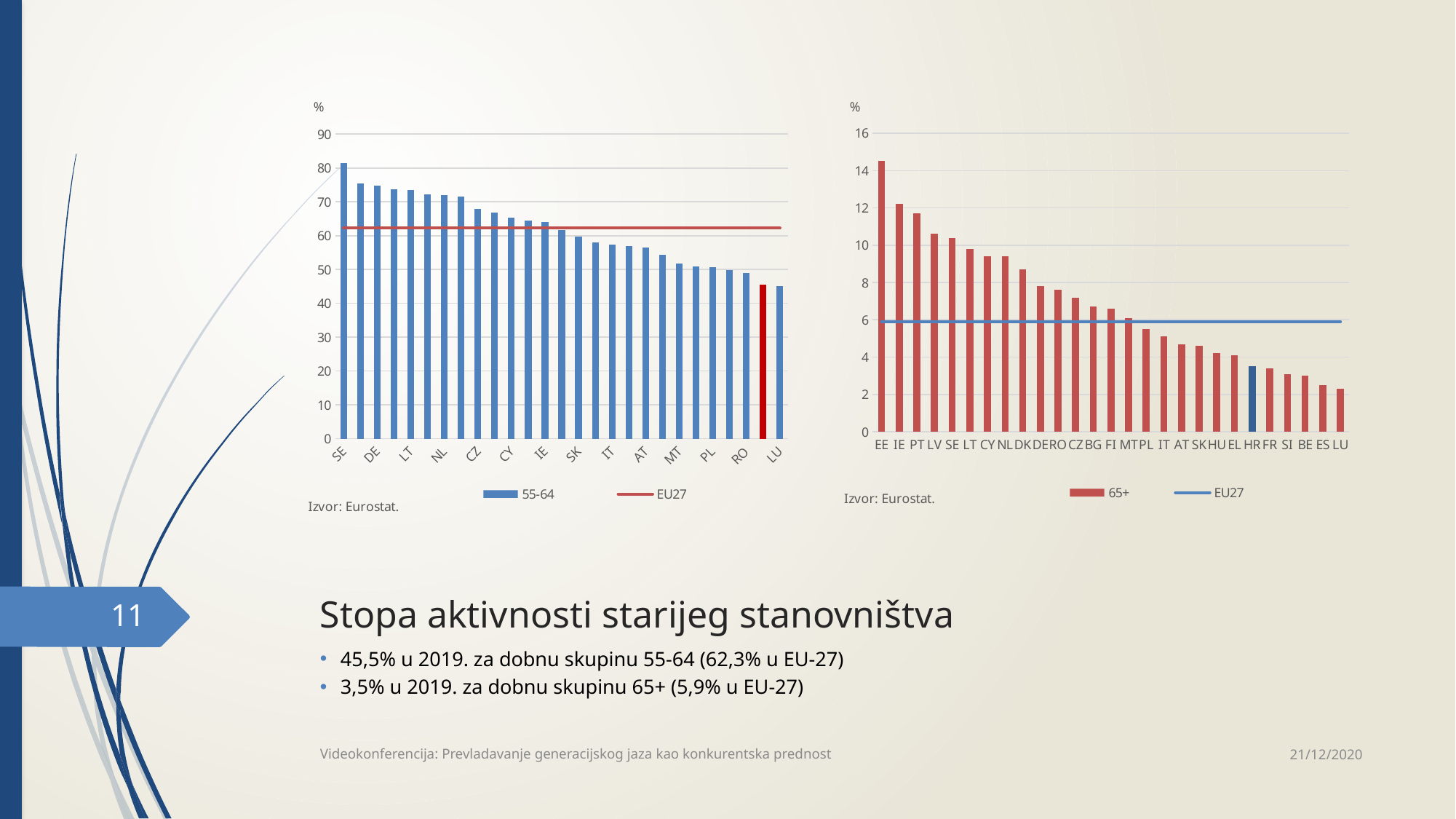
In the right chart (65+), do the bar values rise or fall from left to right along the x axis? fall In the right chart (65+), is the value for HR greater or less than 4? less In the left chart (55-64), what colour is the horizontal EU27 line? red In the right chart (65+), which country has the highest value? EE In the left chart (55-64), is the value for SE greater or less than 70? greater In the left chart (55-64), is the value for LU greater or less than 50? less How many series does the legend of the right chart (65+) list? 2 In the right chart (65+), which country has the lowest value? LU In the right chart (65+), which is larger, the value for EE or the value for LU? EE In the left chart (55-64), which country has the highest value? SE What kind of chart is the left chart (55-64)? bar chart